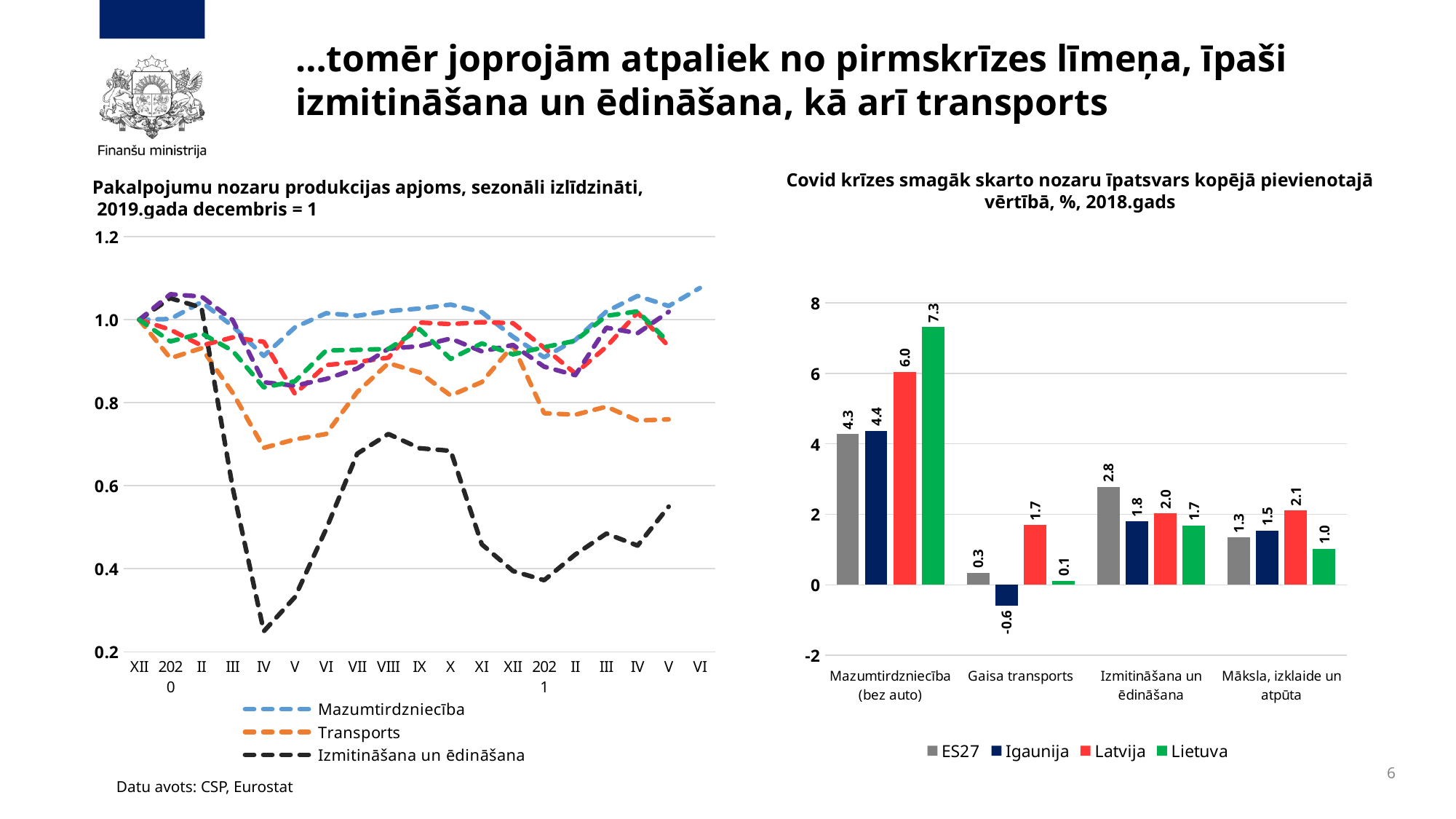
In the right chart, which country has the highest value in Mazumtirdzniecība (bez auto)? Lietuva In the left chart, how many series does the legend list? 3 In the right chart, what is the value for ES27 in Izmitināšana un ēdināšana? 2.8 What kind of chart is the left chart (Pakalpojumu nozaru produkcijas apjoms)? line chart In the right chart, what is the value for Igaunija in Gaisa transports? -0.6 In the right chart, how many series does the legend list? 4 In the right chart, what is the difference between Latvija and ES27 in Mazumtirdzniecība (bez auto)? 1.7 In the right chart, which is larger in Izmitināšana un ēdināšana: Latvija or Lietuva? Latvija In the right chart, which country has the lowest value in Māksla, izklaide un atpūta? Lietuva In the right chart (Covid krīzes smagāk skarto nozaru īpatsvars), what is the value for Latvija in Mazumtirdzniecība (bez auto)? 6.0 In the left chart, is the value for Izmitināšana un ēdināšana at IV 2020 greater or less than 0.4? less In the right chart, how many sector categories are shown on the x axis? 4